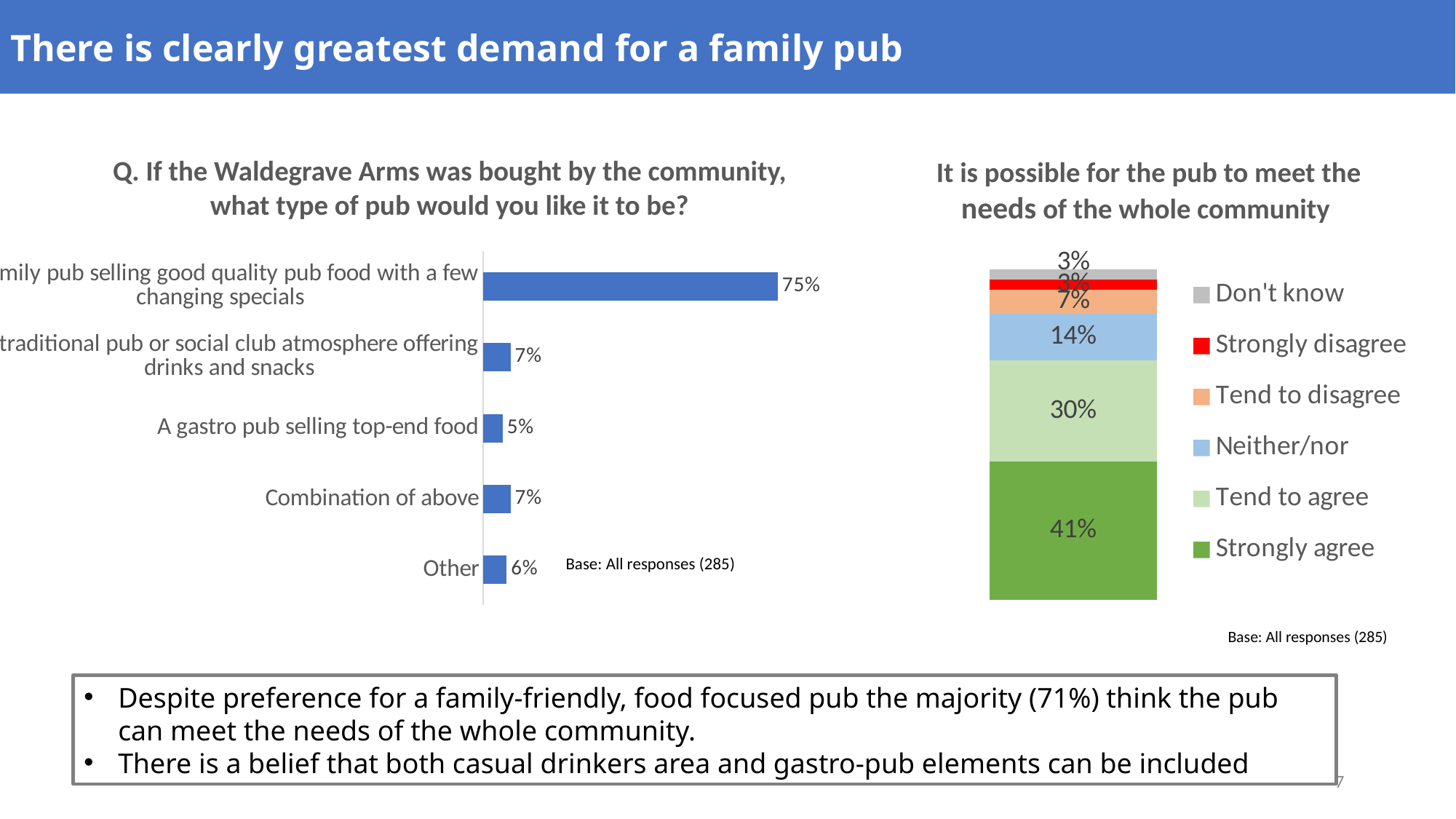
In the left chart, what is the value for 'A gastro pub selling top-end food'? 5% In the left chart, which pub type has the highest value? Family pub selling good quality pub food with a few changing specials What kind of chart is the left chart? Bar chart In the left chart, how many pub type categories are shown? 5 In the right chart, how many response categories does the legend list? 6 In the left chart, what is the difference between the family pub option (75%) and 'Combination of above' (7%)? 68% In the right chart 'It is possible for the pub to meet the needs of the whole community', what percentage strongly agree? 41% In the left chart, which pub type has the lowest value? A gastro pub selling top-end food In the right chart, what percentage tend to agree? 30% In the left chart, what percentage of respondents chose a family pub selling good quality pub food with a few changing specials? 75% In the left chart, what is the value for 'Other'? 6% In the left chart, what is the value for 'Combination of above'? 7%